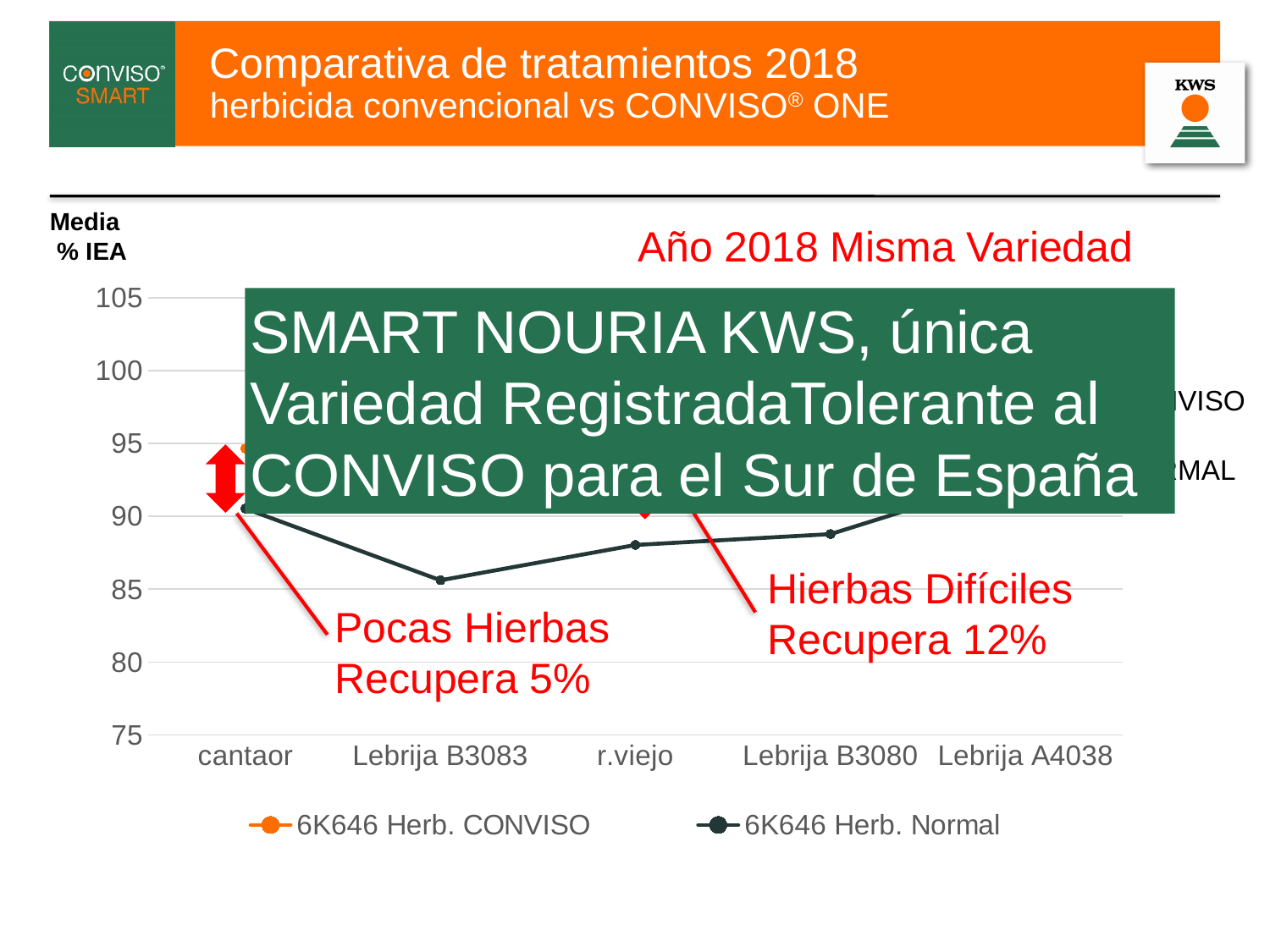
In the 6K646 Herb. Normal series, which is larger: the value for cantaor or the value for Lebrija B3083? cantaor What is the label shown on the y axis of the chart? Media % IEA What is the lowest value shown on the y axis of the chart? 75 Is the value for Lebrija B3083 in the 6K646 Herb. Normal series greater or less than 90? less In the 6K646 Herb. Normal series, does the value rise or fall from cantaor to Lebrija B3083? fall What are the two series named in the chart legend? 6K646 Herb. CONVISO and 6K646 Herb. Normal Is the value for r.viejo in the 6K646 Herb. Normal series greater or less than 90? less Which category has the lowest value in the 6K646 Herb. Normal series? Lebrija B3083 How many series does the chart legend list? 2 What kind of chart is shown on the slide? line chart Is the value for Lebrija B3083 in the 6K646 Herb. Normal series greater or less than 80? greater How many categories are shown on the x axis of the chart? 5